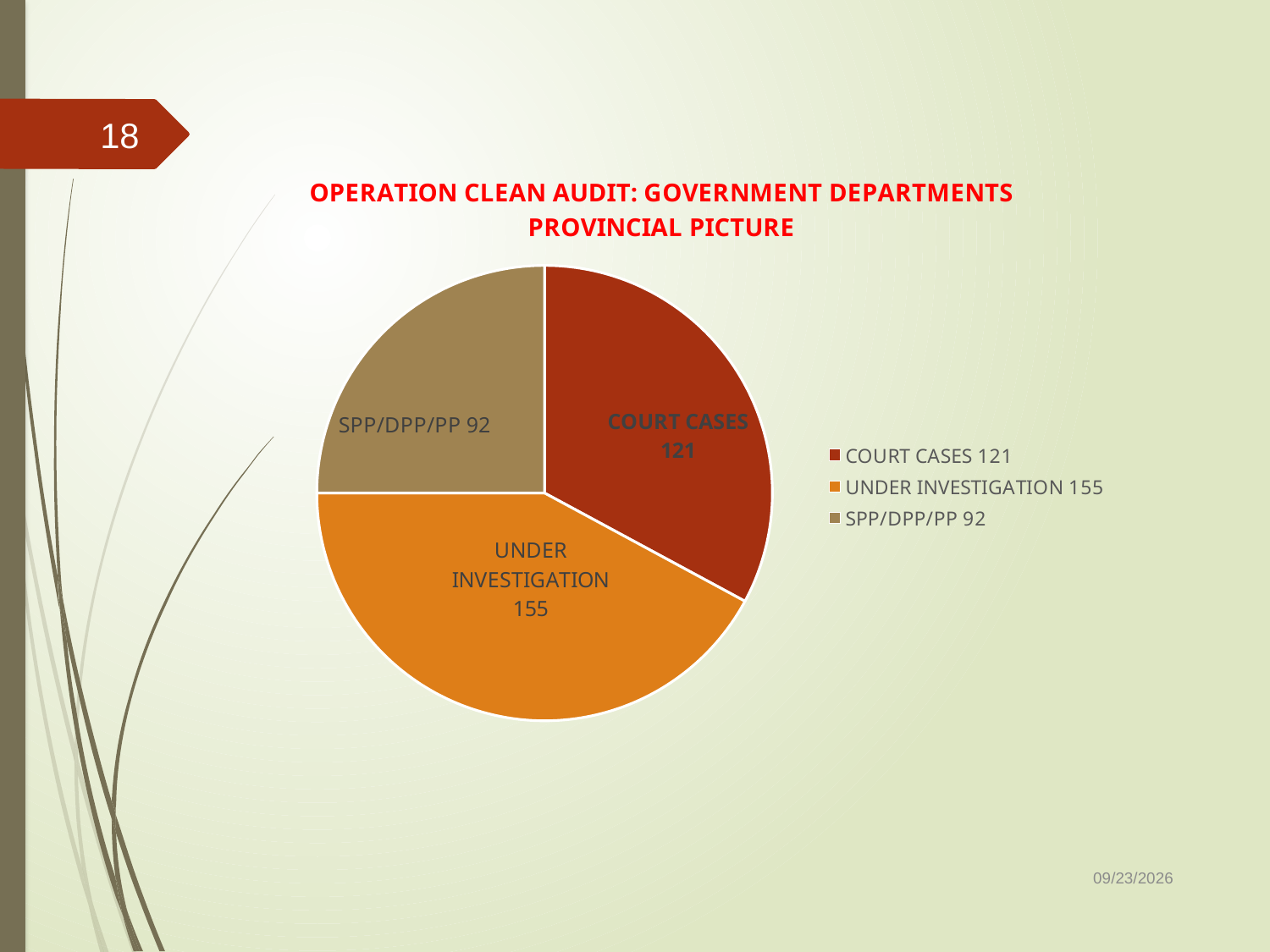
What share of the pie does the SPP/DPP/PP slice represent? 25% What is the total of all three slices in the pie chart? 368 What kind of chart is shown on the slide? Pie chart Which is larger, COURT CASES or SPP/DPP/PP? COURT CASES What is the difference between the UNDER INVESTIGATION value and the COURT CASES value? 34 What is the value for UNDER INVESTIGATION in the pie chart? 155 What is the value for COURT CASES in the pie chart? 121 What is the value for SPP/DPP/PP in the pie chart? 92 Which category has the smallest slice in the pie chart? SPP/DPP/PP Which category has the largest slice in the pie chart? UNDER INVESTIGATION How many categories are shown in the pie chart? 3 What is the difference between the COURT CASES value and the SPP/DPP/PP value? 29